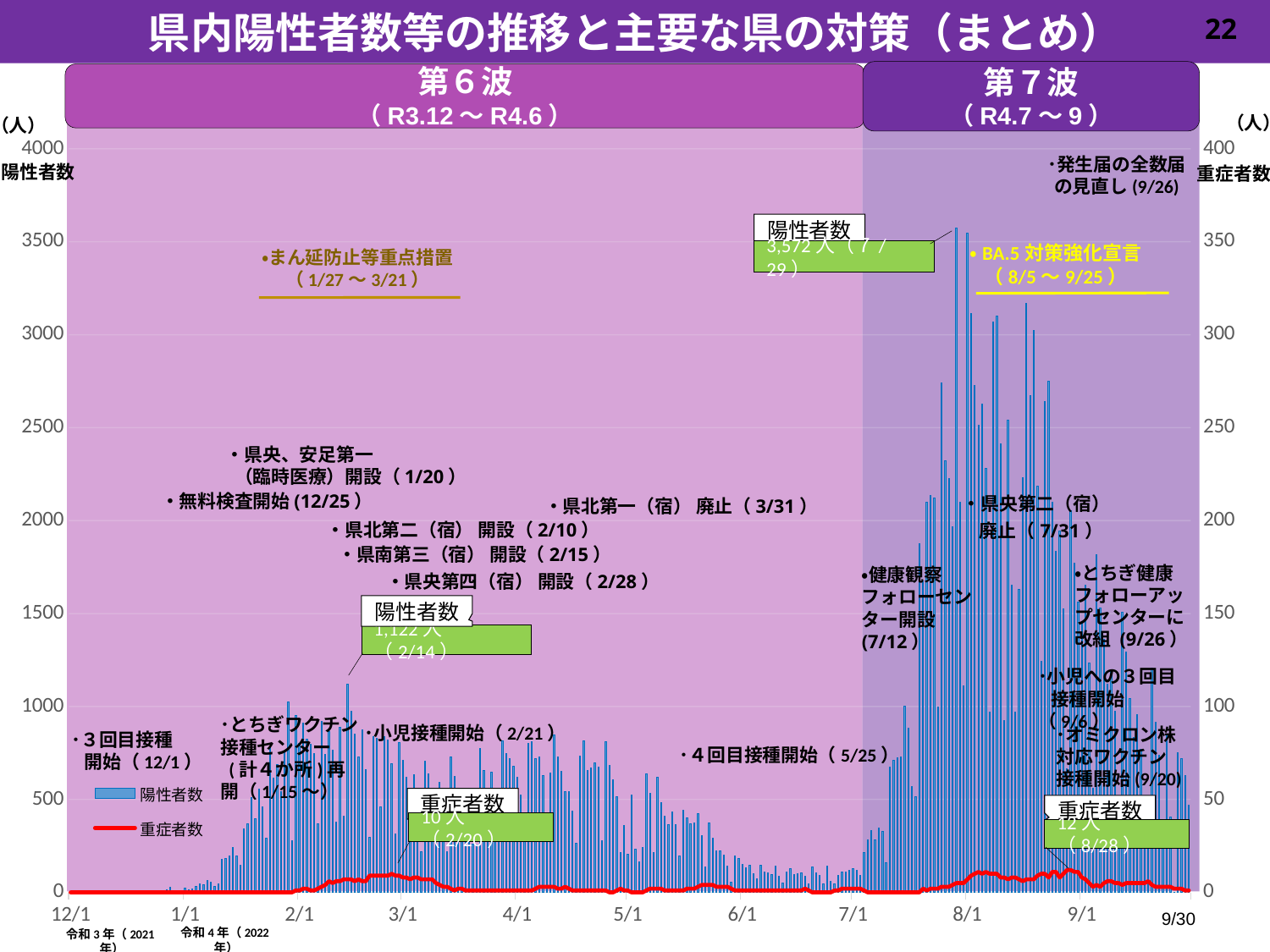
Is the peak of positive cases in the 第7波 period greater or less than 3000? greater According to the callout, what was the number of severe cases (重症者数) on 8/28? 12人 According to the callout, what was the number of positive cases (陽性者数) on 2/14? 1,122人 According to the callout, what was the number of severe cases (重症者数) on 2/20? 10人 According to the callout, what was the number of positive cases (陽性者数) on 7/29? 3,572人 What kind of chart is shown on the slide? bar chart with a line What is the maximum value shown on the left axis (陽性者数)? 4000 What is the difference between the severe case counts labelled for 8/28 and 2/20? 2人 How many series does the legend list? 2 What is the difference between the positive case counts labelled for 7/29 and 2/14? 2,450人 Which date had more positive cases according to the callouts, 2/14 or 7/29? 7/29 What colour is the 重症者数 series in the legend? red